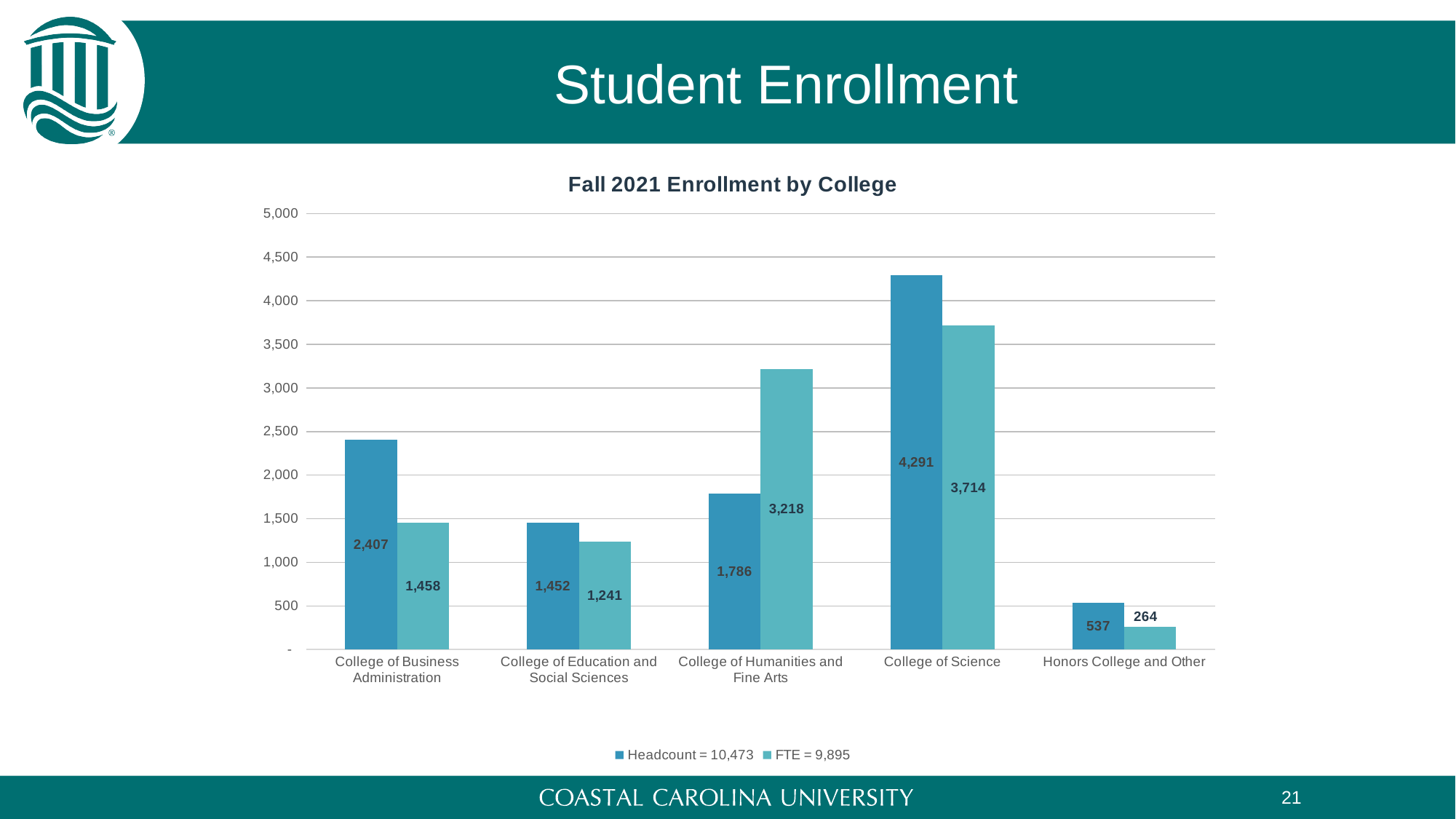
What is the title of the chart? Fall 2021 Enrollment by College How many series does the legend list? 2 How many colleges are shown on the x axis? 5 Which college has the highest Headcount? College of Science What kind of chart is shown on the slide? Bar chart What is the FTE value for the College of Business Administration? 1,458 Which college has the lowest FTE value? Honors College and Other What is the Headcount for the College of Science? 4,291 What is the FTE value for the College of Education and Social Sciences? 1,241 What is the Headcount for Honors College and Other? 537 Which is larger for the College of Humanities and Fine Arts, the Headcount or the FTE value? FTE What is the difference between the Headcount and FTE values for the College of Science? 577